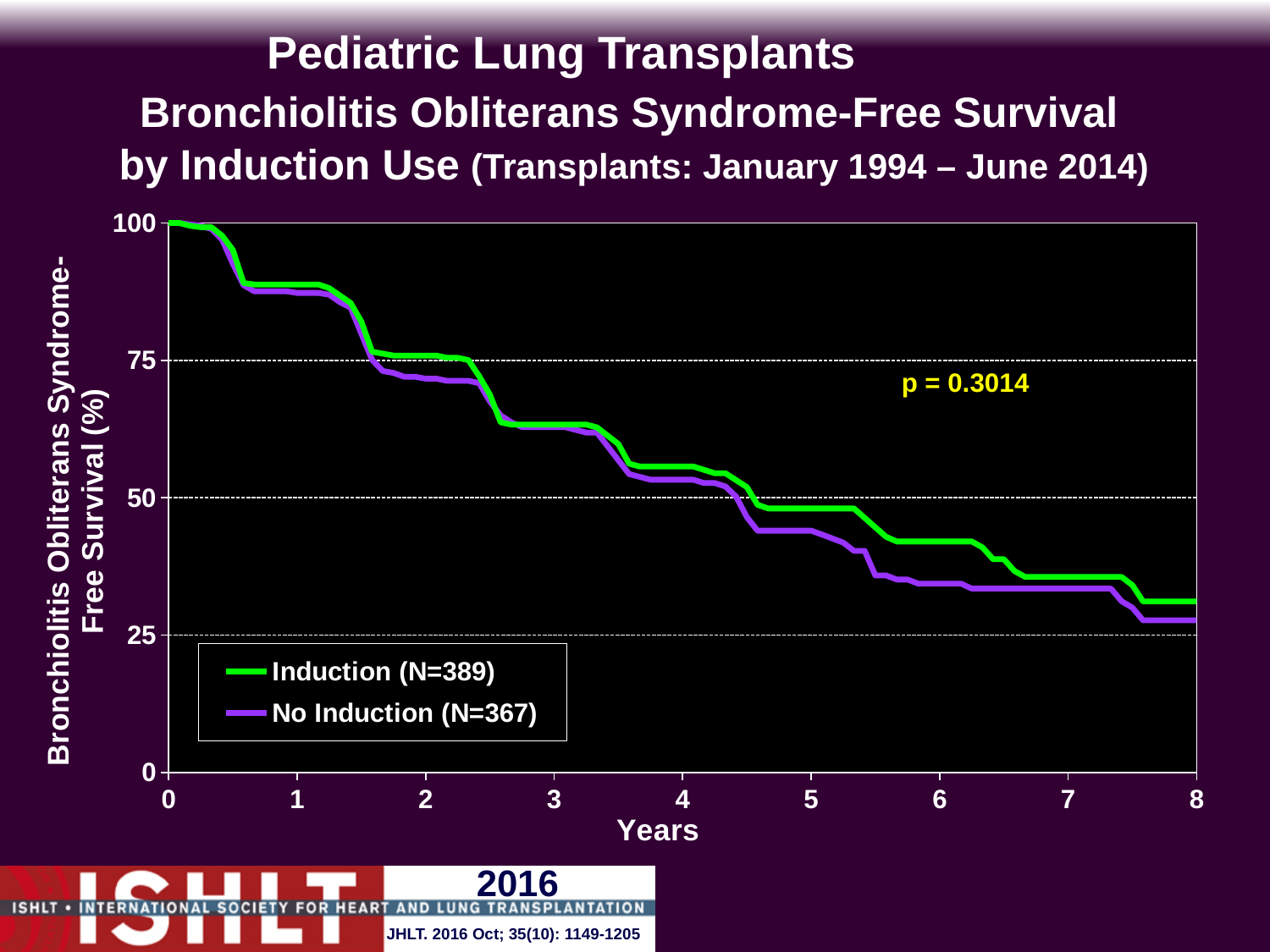
Is the value for Induction at 3 years greater or less than 75? less Is the value for No Induction at 1 year greater or less than 75? greater Is the value for Induction at 8 years greater or less than 25? greater What is the BOS-free survival value for both groups at 0 years? 100 What is the N for the No Induction group in the legend? 367 What p-value is shown on the chart? p = 0.3014 Do the survival curves rise or fall as years increase? fall What kind of chart is shown on the slide? line chart At 6 years, which group has the higher BOS-free survival, Induction or No Induction? Induction How many series does the legend list? 2